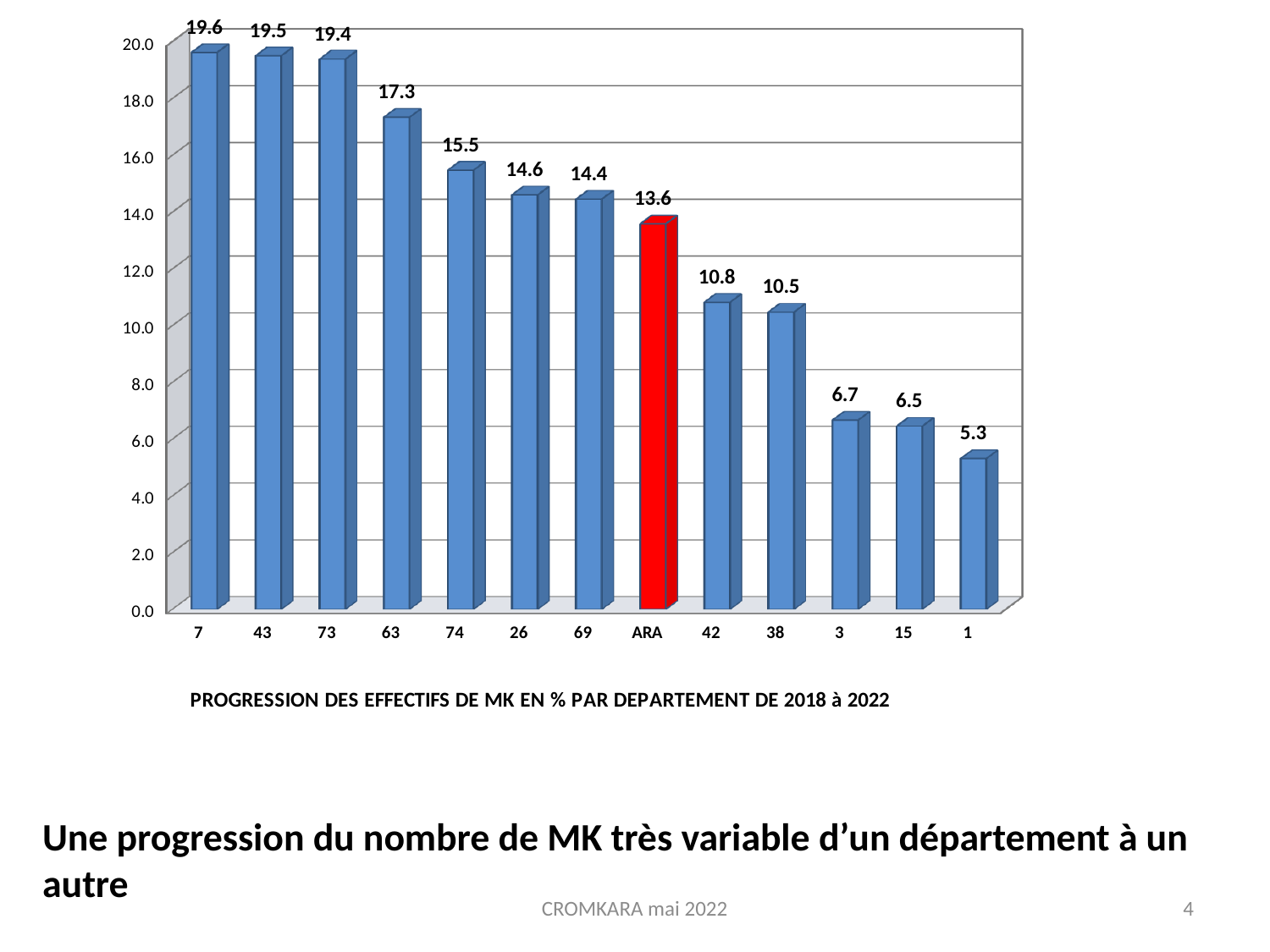
Which category has the lowest value? 1 What is the value for ARA? 13.6 What kind of chart is shown on the slide? bar chart What is the value for department 38? 10.5 What is the difference between the values for ARA and department 42? 2.8 Which category has the highest value? 7 Is the value for department 3 greater or less than 8.0? less What is the value for department 63? 17.3 What is the difference between the values for department 7 and department 1? 14.3 Which is larger, the value for department 74 or the value for department 26? 74 How many categories are shown on the x axis? 13 Which bar is coloured red instead of blue? ARA